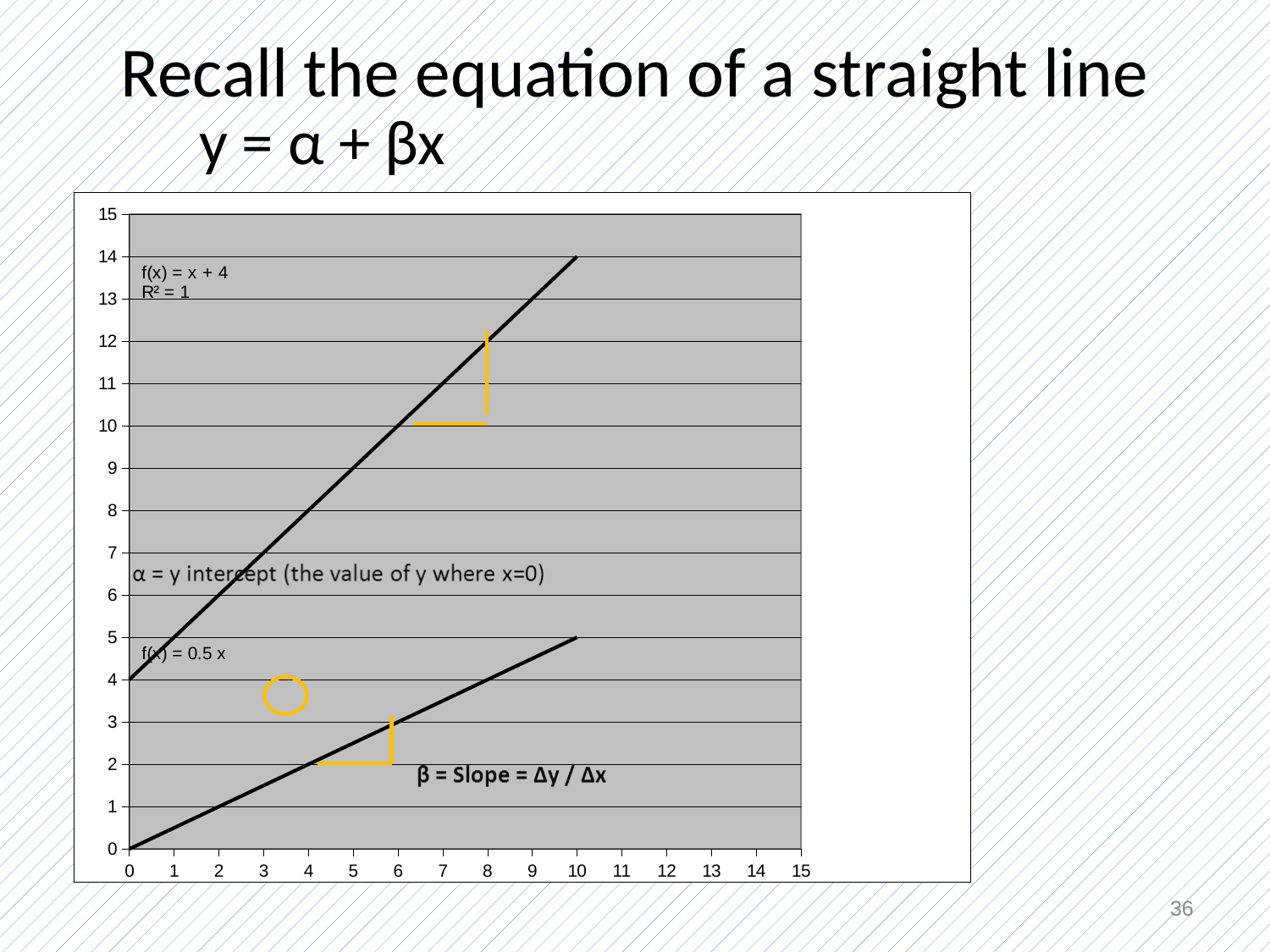
What equation is printed for the lower line on the chart? f(x) = 0.5 x What kind of chart is shown on the slide? line chart Do the values of the lines rise or fall as x increases? rise Is the value of the line f(x) = x + 4 at x = 5 greater or less than 8? greater What is the highest value shown on the y axis? 15 Which line is steeper, f(x) = x + 4 or f(x) = 0.5 x? f(x) = x + 4 What equation is printed for the upper line on the chart? f(x) = x + 4 Is the value of the line f(x) = 0.5 x at x = 10 greater or less than 10? less How many lines are plotted on the chart? 2 At what y value does the line f(x) = x + 4 cross the y axis (x = 0)? 4 What is the highest value shown on the x axis? 15 What R² value is printed on the chart? R² = 1